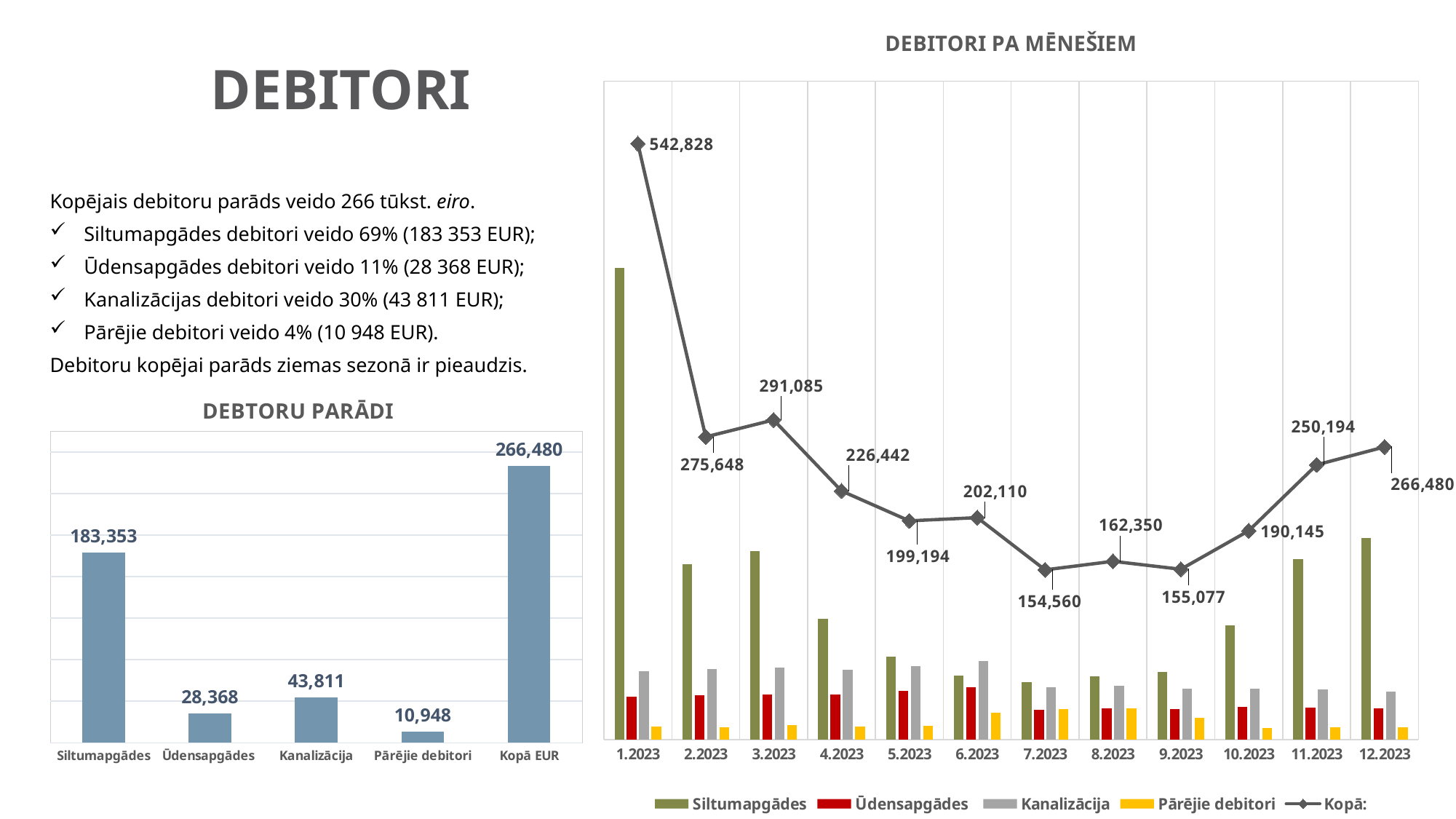
In the 'DEBTORU PARĀDI' chart, what is the difference between Kanalizācija and Ūdensapgādes? 15,443 In the 'DEBTORU PARĀDI' chart, what is the value for Pārējie debitori? 10,948 In the 'DEBITORI PA MĒNEŠIEM' chart, what is the Kopā value for 1.2023? 542,828 In the 'DEBTORU PARĀDI' chart, what kind of chart is it? Bar chart In the 'DEBTORU PARĀDI' chart, how many bars are shown? 5 In the 'DEBITORI PA MĒNEŠIEM' chart, how many series does the legend list? 5 In the 'DEBITORI PA MĒNEŠIEM' chart, does the Kopā line rise or fall from 1.2023 to 7.2023? Fall In the 'DEBTORU PARĀDI' chart, what is the value for Siltumapgādes? 183,353 In the 'DEBTORU PARĀDI' chart, which category other than Kopā EUR has the lowest value? Pārējie debitori In the 'DEBITORI PA MĒNEŠIEM' chart, which month has the lowest Kopā value? 7.2023 In the 'DEBITORI PA MĒNEŠIEM' chart, what is the difference between the Kopā values for 12.2023 and 11.2023? 16,286 In the 'DEBITORI PA MĒNEŠIEM' chart, what is the Kopā value for 9.2023? 155,077